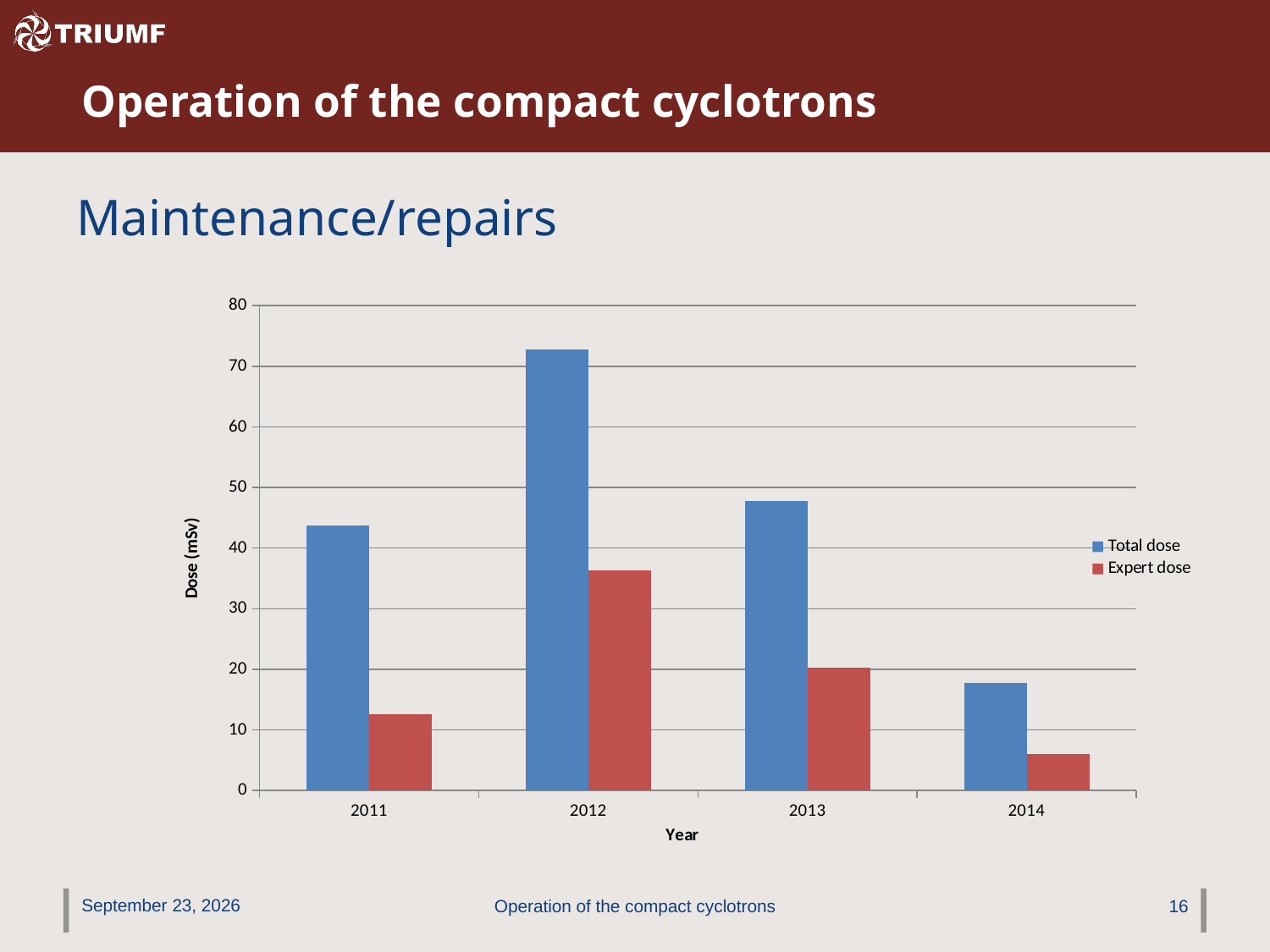
How many series does the legend list? 2 Which year has the highest Expert dose? 2012 Which year has the lowest Total dose? 2014 Which year has the lowest Expert dose? 2014 Is the Total dose for 2014 greater or less than 20? less Which year has the highest Total dose? 2012 How many years are shown on the x axis? 4 Is the Total dose for 2012 greater or less than 70? greater What kind of chart is shown on the slide? bar chart Which is larger, the Expert dose for 2011 or the Expert dose for 2013? 2013 What is the label of the vertical axis? Dose (mSv) Is the Expert dose for 2014 greater or less than 10? less